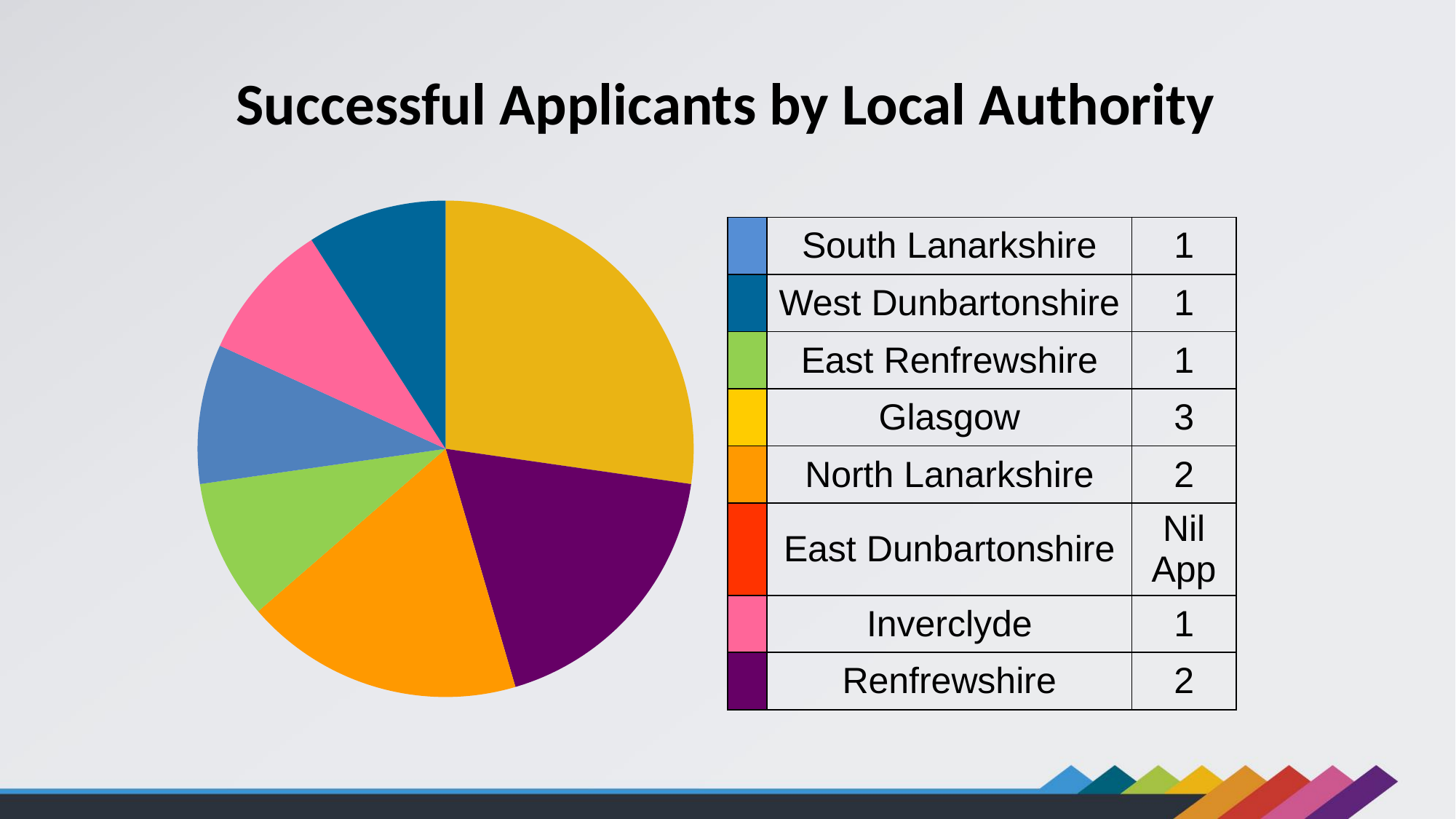
How many successful applicants does the table show for North Lanarkshire? 2 Which local authority has the highest number of successful applicants? Glasgow What is the total number of successful applicants across all local authorities listed in the table? 11 Which has more successful applicants, North Lanarkshire or South Lanarkshire? North Lanarkshire What value is shown for East Dunbartonshire in the table? Nil App What is the difference between the number of successful applicants for Glasgow and for Renfrewshire? 1 What is the title of the chart? Successful Applicants by Local Authority What colour is the slice for Renfrewshire in the pie chart? purple How many successful applicants does the table show for Glasgow? 3 How many successful applicants does the table show for Inverclyde? 1 What kind of chart is shown on the slide? pie chart How many slices does the pie chart have? 7